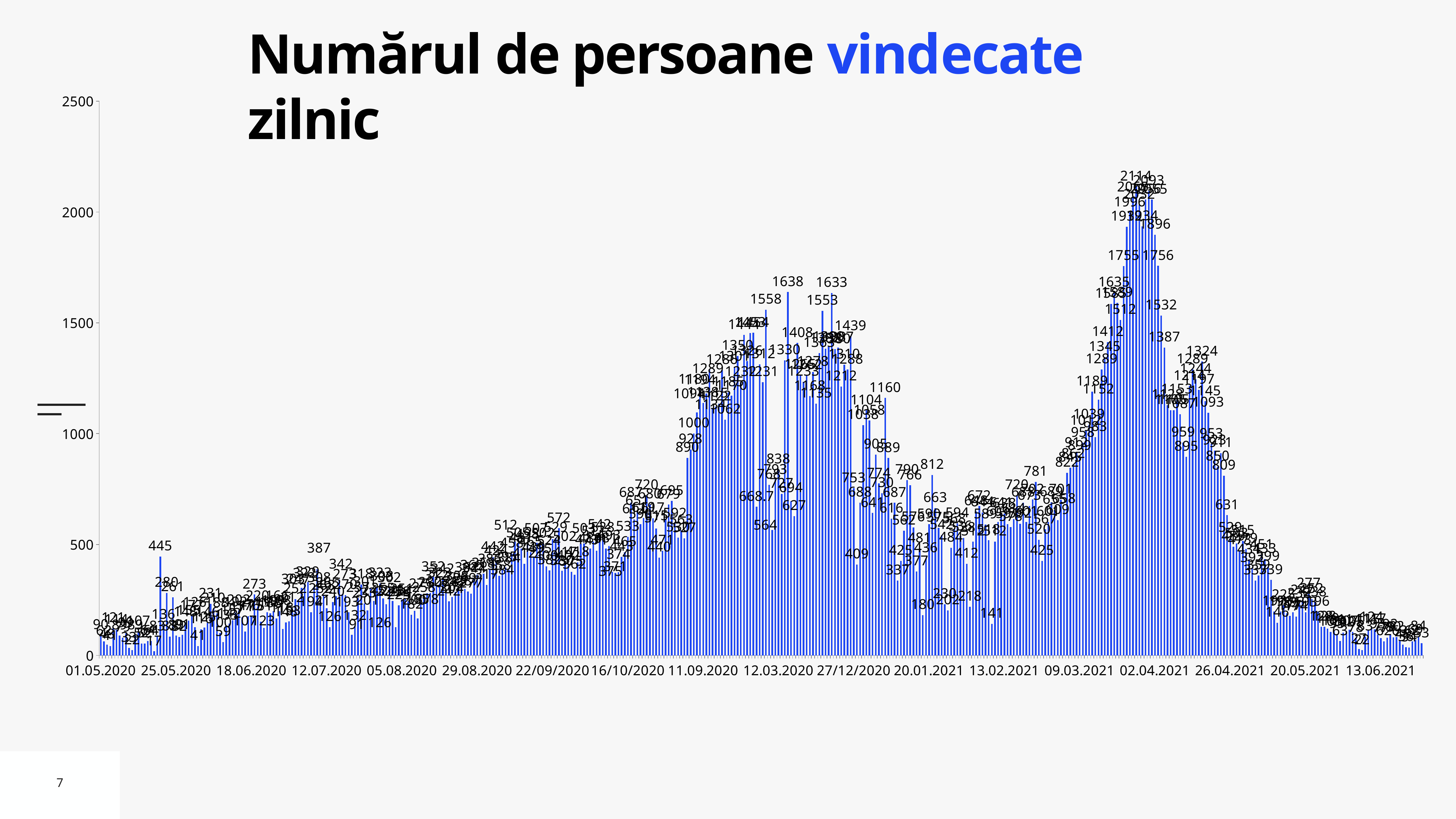
What is the difference between the labelled values 1638 and 1558? 80 What is the highest tick value shown on the vertical axis? 2500 Which is larger, the labelled value 445 or the labelled value 387? 445 Is the value for 13.06.2021 greater or less than 500? less What is the value of the tallest bar in the small peak shortly after 25.05.2020? 445 What kind of chart is shown on the slide? bar chart Is the value for 01.05.2020 greater or less than 500? less Is the value for 02.04.2021 greater or less than 1500? greater What is the highest value labelled on the chart? 2114 What is the title of the chart? Numărul de persoane vindecate zilnic Do the values rise or fall between 02.04.2021 and 13.06.2021? fall